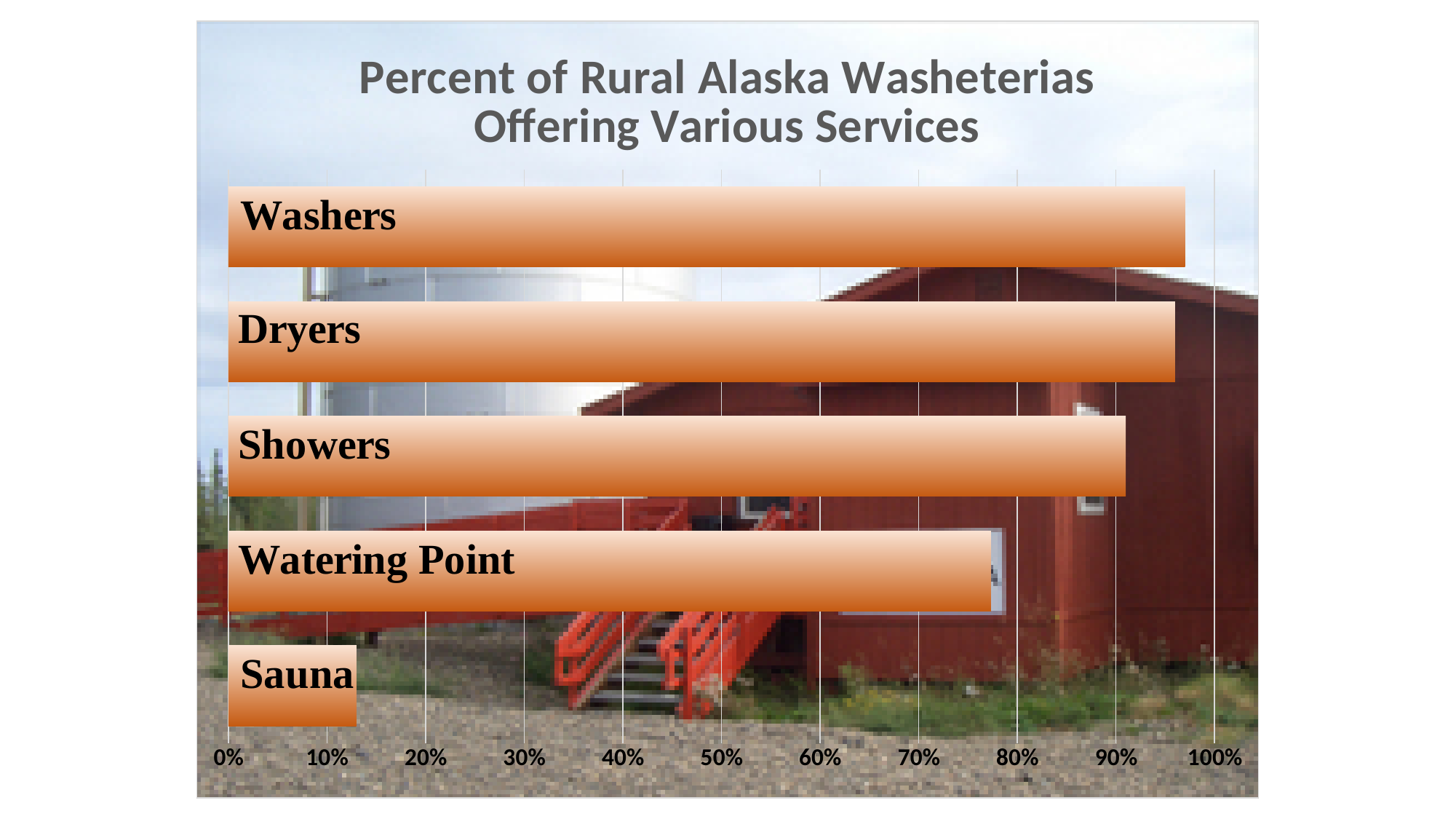
What type of chart is shown on the slide? bar chart Is the value for Sauna greater or less than 20%? less Which service has the lowest percentage of washeterias offering it? Sauna Is the value for Dryers greater or less than 90%? greater Is the value for Showers greater or less than 80%? greater Which is larger, the value for Sauna or the value for Watering Point? Watering Point What is the title of the chart? Percent of Rural Alaska Washeterias Offering Various Services How many services (categories) are shown in the chart? 5 Which is larger, the value for Showers or the value for Watering Point? Showers